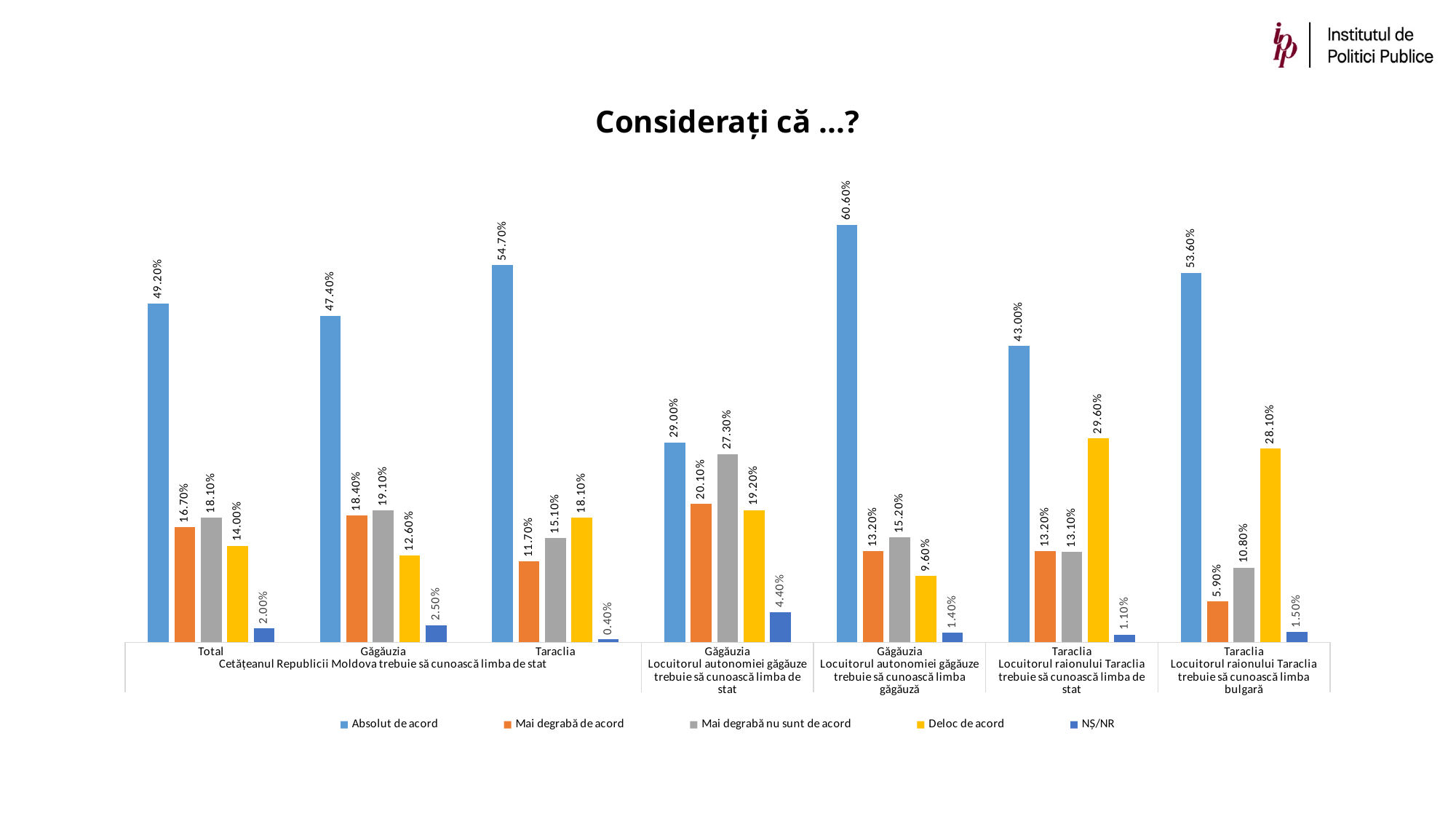
What is the title of the chart? Considerați că ...? What kind of chart is shown on the slide? Bar chart What is the value of "Mai degrabă nu sunt de acord" for Găgăuzia under "Locuitorul autonomiei găgăuze trebuie să cunoască limba de stat"? 27.30% Under "Locuitorul autonomiei găgăuze trebuie să cunoască limba de stat", which is larger for Găgăuzia: "Absolut de acord" or "Mai degrabă nu sunt de acord"? Absolut de acord Which category group has the highest "Absolut de acord" value? Găgăuzia – Locuitorul autonomiei găgăuze trebuie să cunoască limba găgăuză (60.60%) What is the value of "Absolut de acord" for Total under "Cetățeanul Republicii Moldova trebuie să cunoască limba de stat"? 49.20% What is the value of "Deloc de acord" for Taraclia under "Locuitorul raionului Taraclia trebuie să cunoască limba de stat"? 29.60% What is the difference between the "Absolut de acord" values for Taraclia and Găgăuzia under "Cetățeanul Republicii Moldova trebuie să cunoască limba de stat"? 7.30% How many series does the legend list? 5 How many category groups are shown on the x axis? 7 Which category group has the lowest "NȘ/NR" value? Taraclia – Cetățeanul Republicii Moldova trebuie să cunoască limba de stat (0.40%) What is the value of "Mai degrabă de acord" for Taraclia under "Locuitorul raionului Taraclia trebuie să cunoască limba bulgară"? 5.90%